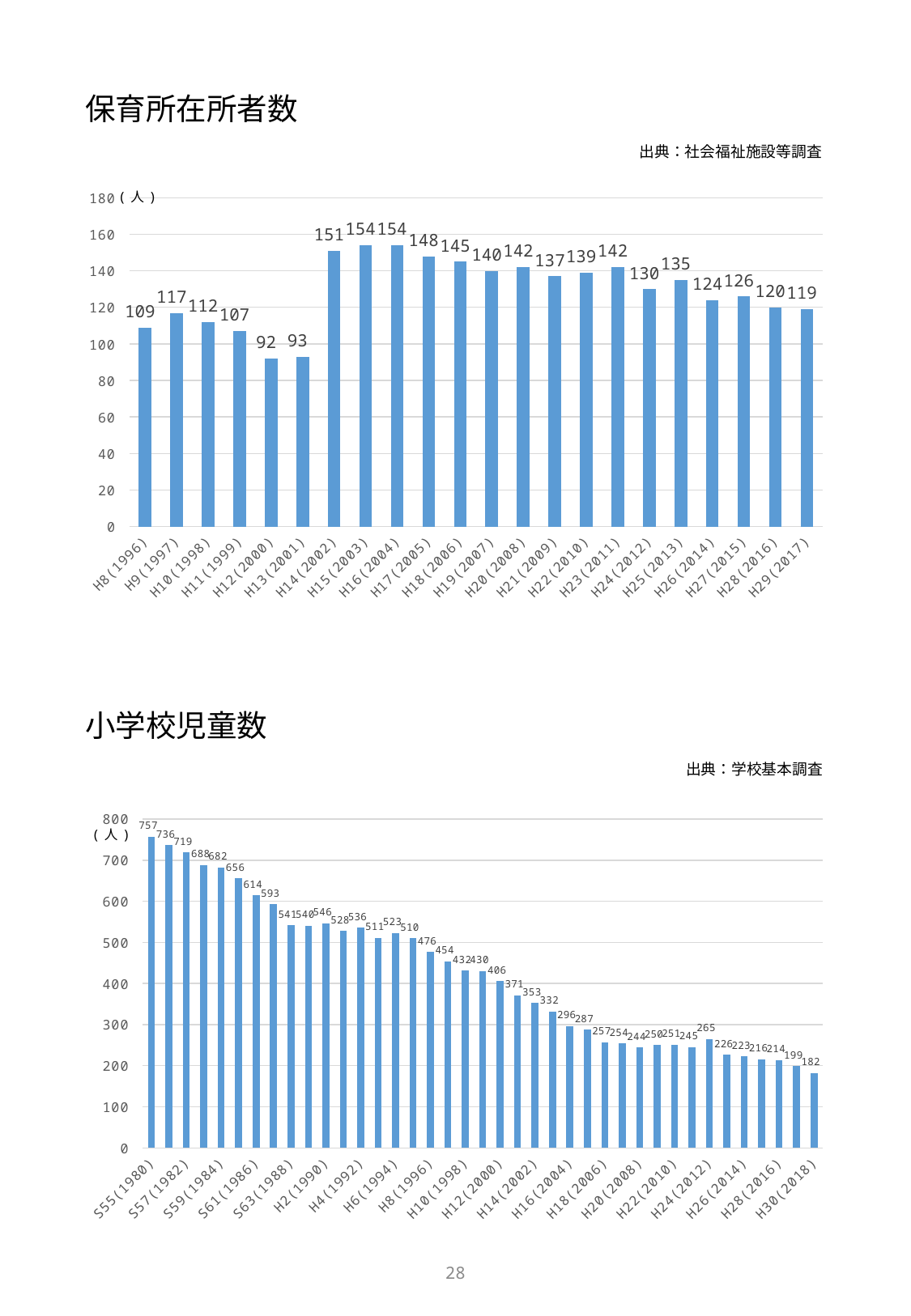
In the 保育所在所者数 chart, is the value for H24(2012) larger or smaller than the value for H25(2013)? smaller In the 小学校児童数 chart, what is the overall trend of the values from left to right? falling In the 保育所在所者数 chart, which year has the lowest value? H12(2000) In the 小学校児童数 chart, what is the value for H30(2018)? 182 What type of chart is the 小学校児童数 chart? bar chart In the 小学校児童数 chart, what is the value for S55(1980)? 757 In the 小学校児童数 chart, which year has the highest value? S55(1980) In the 小学校児童数 chart, what is the difference between the values for H12(2000) and H14(2002)? 53 In the 保育所在所者数 chart, how many bars are plotted? 22 In the 保育所在所者数 chart, what is the value for H29(2017)? 119 In the 保育所在所者数 chart, what is the value for H12(2000)? 92 In the 保育所在所者数 chart, what is the difference between the values for H14(2002) and H13(2001)? 58